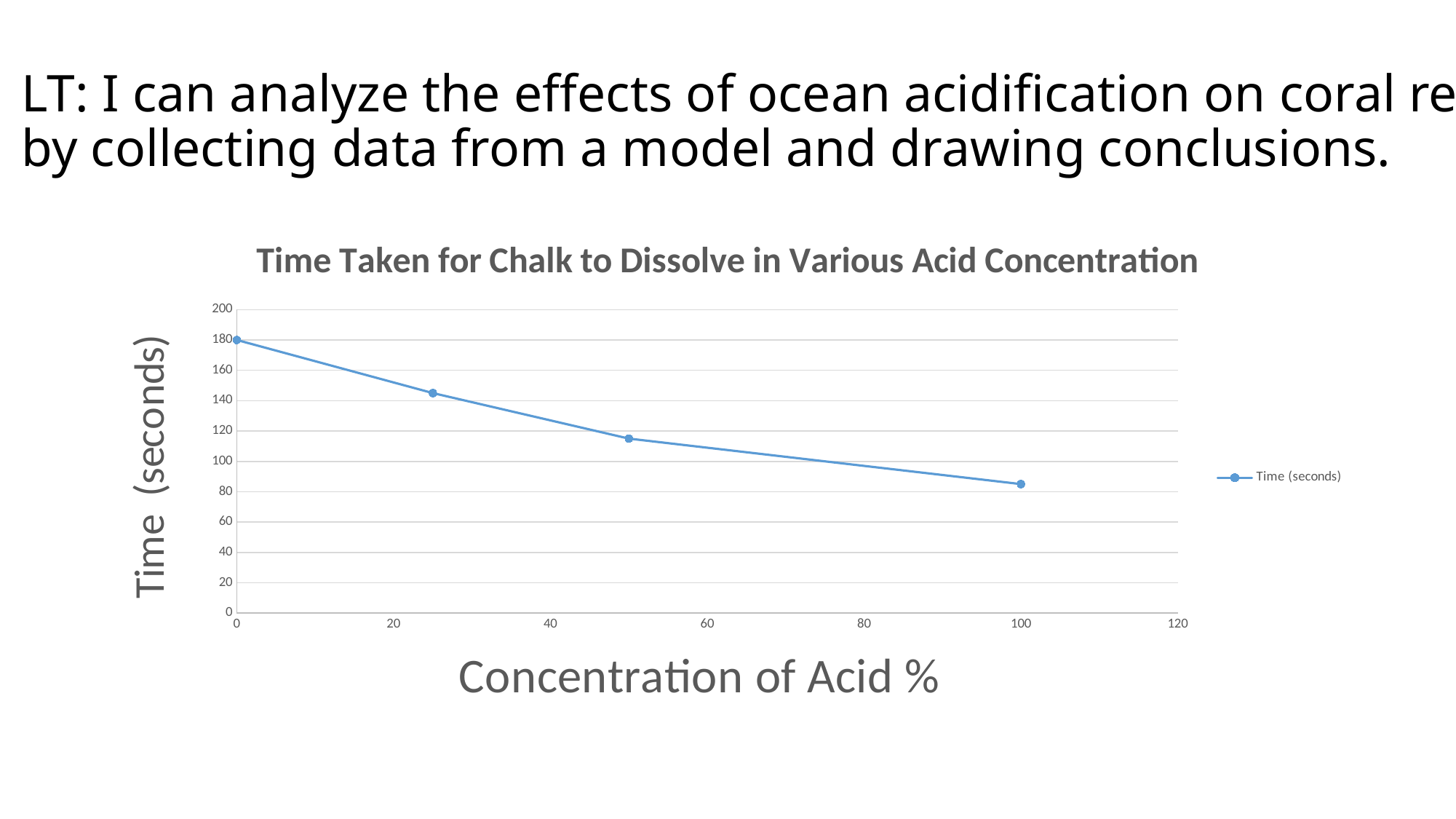
Is the time value at 100% acid concentration greater or less than 100? less Is the time value at 25% acid concentration greater or less than 160? less Does the time taken rise or fall as the concentration of acid increases along the x axis? fall At which acid concentration is the time taken the lowest? 100 At which acid concentration is the time taken the highest? 0 How many series does the legend list? 1 Which has a larger time value: the point at 25% concentration or the point at 50% concentration? 25% concentration What is the name of the series shown in the legend? Time (seconds) What is the title of the chart? Time Taken for Chalk to Dissolve in Various Acid Concentration Is the time value at 50% acid concentration greater or less than 100? greater How many data points are plotted on the chart? 4 What kind of chart is shown on the slide? line chart